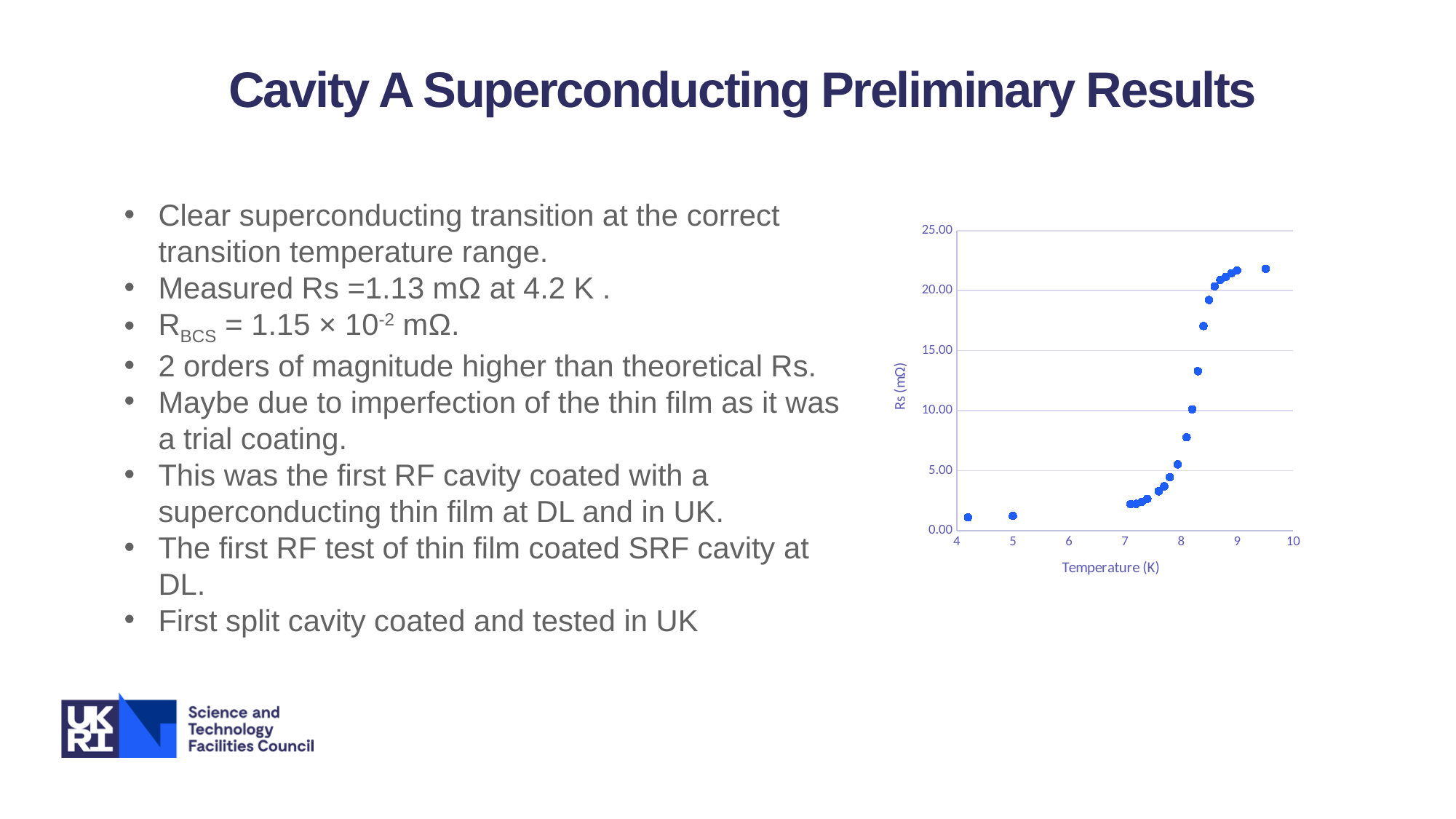
Is the Rs value at a temperature of about 9.5 K greater or less than 20.00? greater Do the Rs values rise or fall as temperature increases along the x axis? rise Is the Rs value at a temperature of about 8.5 K greater or less than 15.00? greater Is the Rs value at a temperature of about 4.2 K greater or less than 5.00? less What is the label of the y axis of the chart? Rs (mΩ) Which has a larger Rs value: the point at about 9 K or the point at about 7 K? the point at about 9 K What is the highest tick value shown on the y axis? 25.00 What is the label of the x axis of the chart? Temperature (K) What kind of chart is shown on the slide? scatter chart